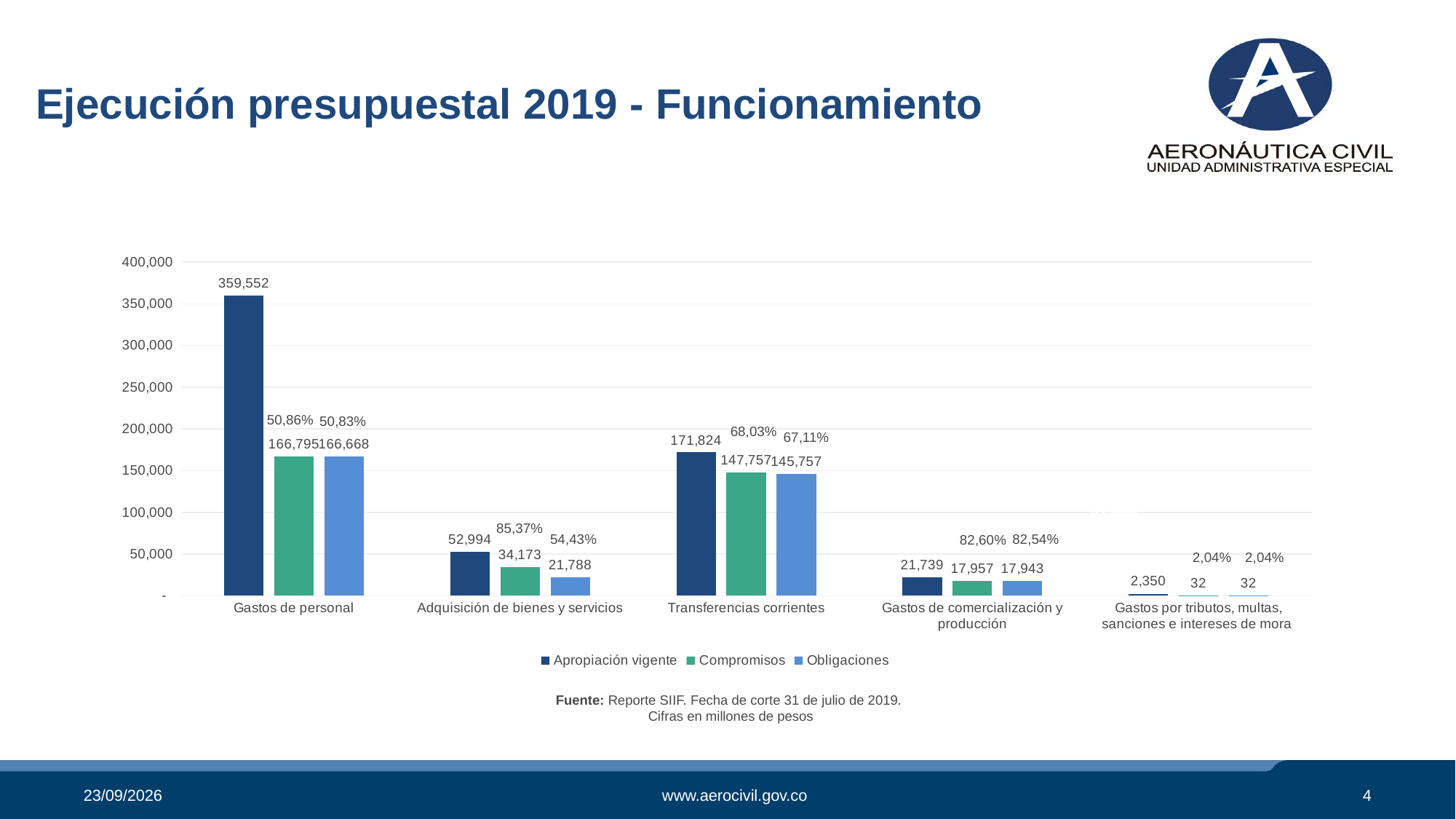
Which is larger: Compromisos for Gastos de personal or Compromisos for Transferencias corrientes? Gastos de personal Which category has the lowest Compromisos value? Gastos por tributos, multas, sanciones e intereses de mora What is the Apropiación vigente value for Gastos de personal? 359,552 What is the Obligaciones value for Adquisición de bienes y servicios? 21,788 How many categories are shown on the x axis of the chart? 5 What is the difference between Compromisos and Obligaciones for Transferencias corrientes? 2,000 How many series does the legend list? 3 What is the difference between Apropiación vigente and Compromisos for Adquisición de bienes y servicios? 18,821 What kind of chart is shown on the slide? bar chart Is the Apropiación vigente value for Transferencias corrientes greater or less than 150,000? greater Which category has the highest Apropiación vigente? Gastos de personal What is the Compromisos value for Transferencias corrientes? 147,757